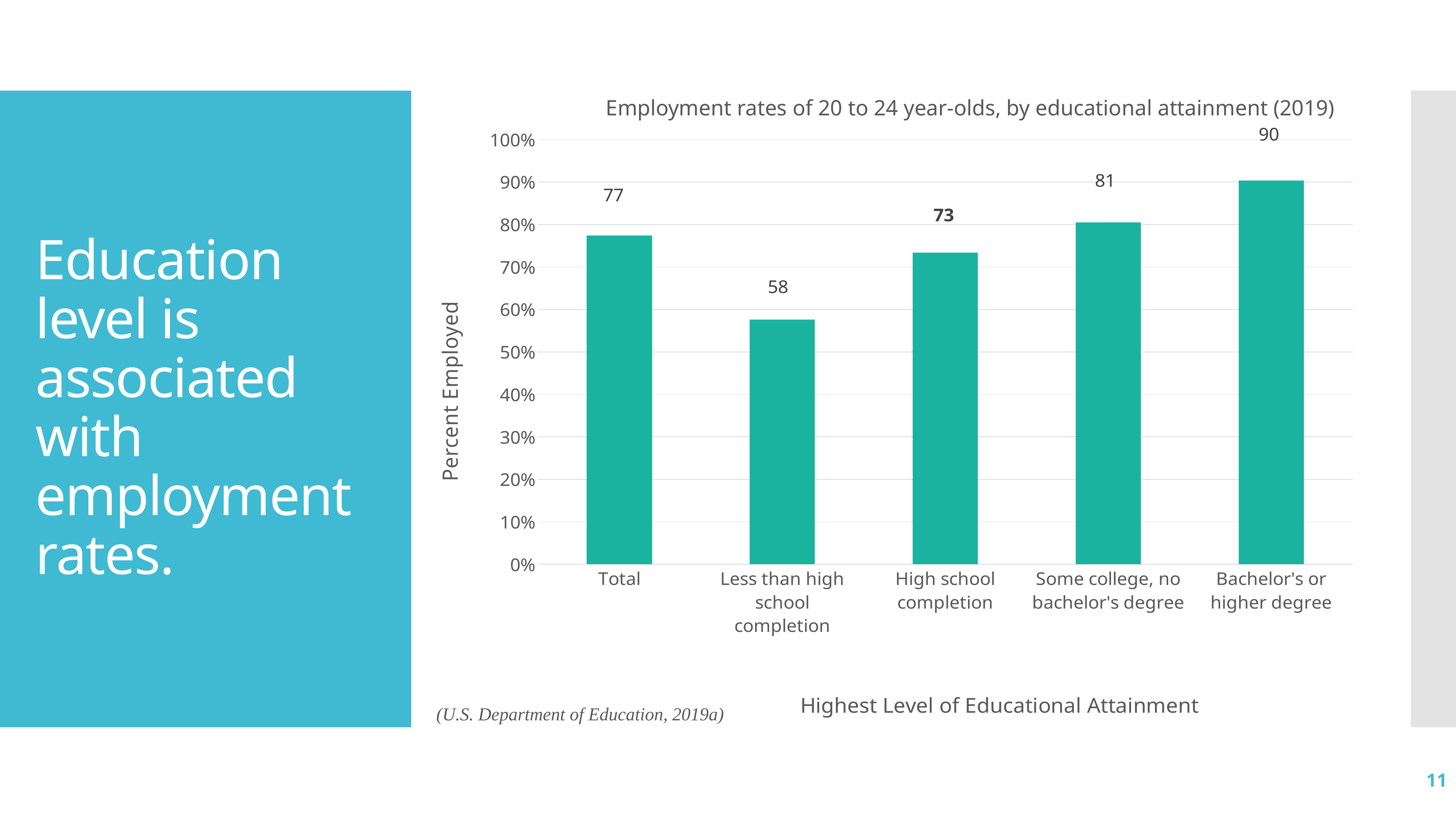
What is the employment rate shown for the Total category? 77 Which educational attainment category has the lowest employment rate? Less than high school completion What is the employment rate for those with some college, no bachelor's degree? 81 What is the label of the vertical axis of the chart? Percent Employed What is the employment rate for those with high school completion? 73 Which has a higher employment rate: High school completion or Some college, no bachelor's degree? Some college, no bachelor's degree How many categories are shown on the x axis of the chart? 5 What is the employment rate for 20 to 24 year-olds with less than high school completion? 58 Which educational attainment category has the highest employment rate? Bachelor's or higher degree What is the difference between the employment rate for Bachelor's or higher degree and for Less than high school completion? 32 What is the title of the chart? Employment rates of 20 to 24 year-olds, by educational attainment (2019) What type of chart is shown on the slide? Bar chart